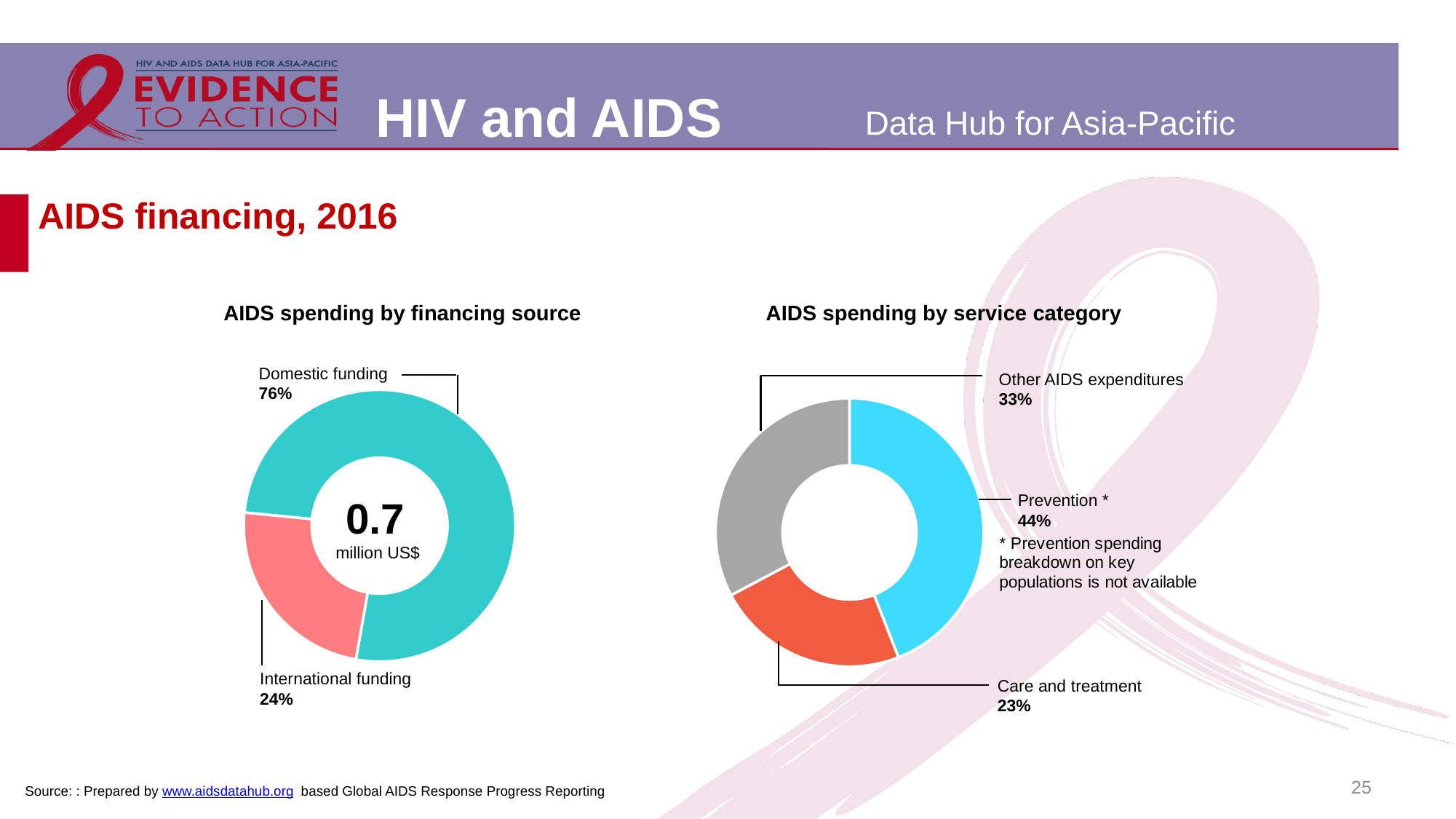
What kind of chart is 'AIDS spending by financing source'? Donut (pie) chart In the 'AIDS spending by service category' chart, which service category has the smallest share? Care and treatment In the 'AIDS spending by service category' chart, what share is Other AIDS expenditures? 33% In the 'AIDS spending by financing source' chart, what share is International funding? 24% In the 'AIDS spending by service category' chart, what is the difference between the Prevention and Other AIDS expenditures shares? 11% In the 'AIDS spending by financing source' chart, which financing source has the larger share? Domestic funding In the 'AIDS spending by service category' chart, how many service categories are shown? 3 In the 'AIDS spending by financing source' chart, what total amount is shown in the centre of the donut? 0.7 million US$ In the 'AIDS spending by service category' chart, what share is Prevention? 44% In the 'AIDS spending by financing source' chart, what share is Domestic funding? 76% In the 'AIDS spending by financing source' chart, what is the difference between Domestic funding and International funding shares? 52% In the 'AIDS spending by service category' chart, what share is Care and treatment? 23%